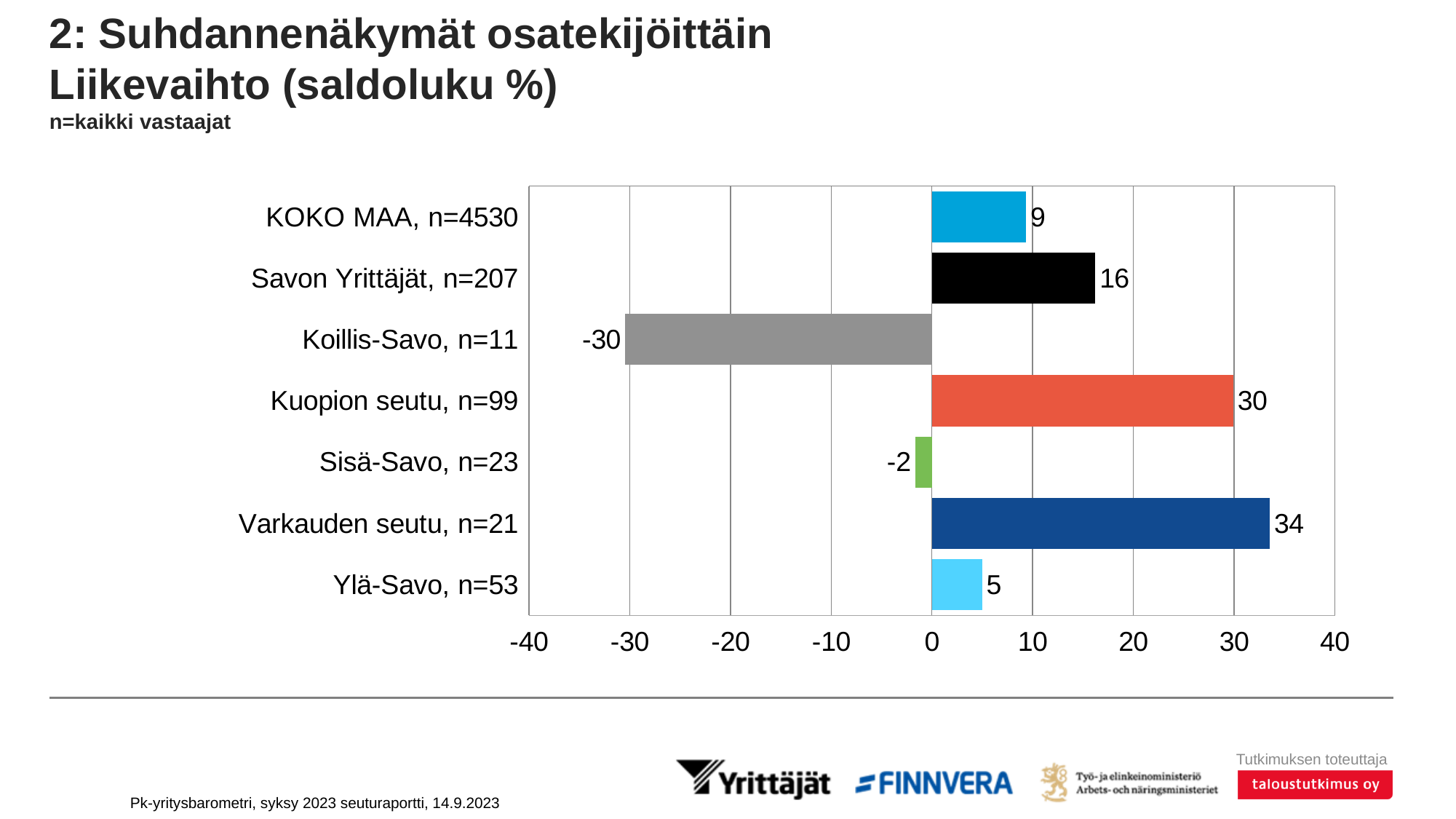
What is the difference between the values for Varkauden seutu, n=21 and Ylä-Savo, n=53? 29 What is the value for KOKO MAA, n=4530? 9 How many categories have a negative value? 2 What is the value for Sisä-Savo, n=23? -2 How many categories are shown in the chart? 7 What is the value for Kuopion seutu, n=99? 30 What kind of chart is shown on the slide? bar chart Is the value for Varkauden seutu, n=21 greater or less than 30? greater Which is larger, the value for Savon Yrittäjät, n=207 or the value for KOKO MAA, n=4530? Savon Yrittäjät, n=207 Which category has the lowest value? Koillis-Savo, n=11 What is the value for Koillis-Savo, n=11? -30 Which category has the highest value? Varkauden seutu, n=21